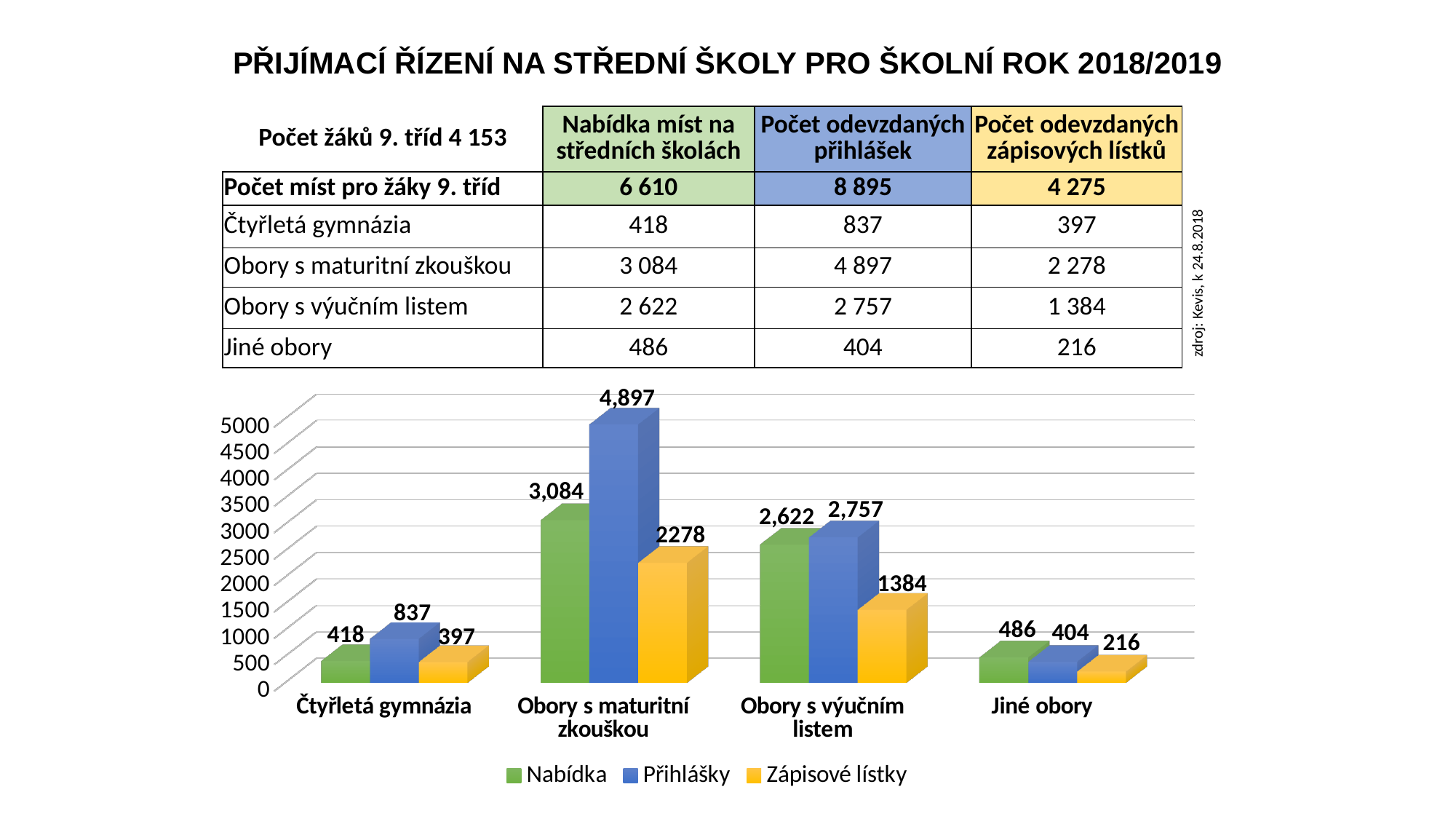
In the chart, is the Nabídka value for Obory s maturitní zkouškou larger or smaller than the Nabídka value for Obory s výučním listem? larger What is the value of Zápisové lístky for Obory s výučním listem in the chart? 1384 Which legend entry is shown in yellow in the chart? Zápisové lístky How many series does the chart legend list? 3 What is the value of Přihlášky for Obory s maturitní zkouškou in the chart? 4,897 What is the difference between Přihlášky and Nabídka for Čtyřletá gymnázia in the chart? 419 Which category has the highest Přihlášky value in the chart? Obory s maturitní zkouškou How many categories are shown on the x axis of the chart? 4 What is the value of Nabídka for Jiné obory in the chart? 486 Which category has the lowest Zápisové lístky value in the chart? Jiné obory Is the Přihlášky value for Obory s maturitní zkouškou greater or less than 4500 in the chart? greater What type of chart is shown on the slide? bar chart